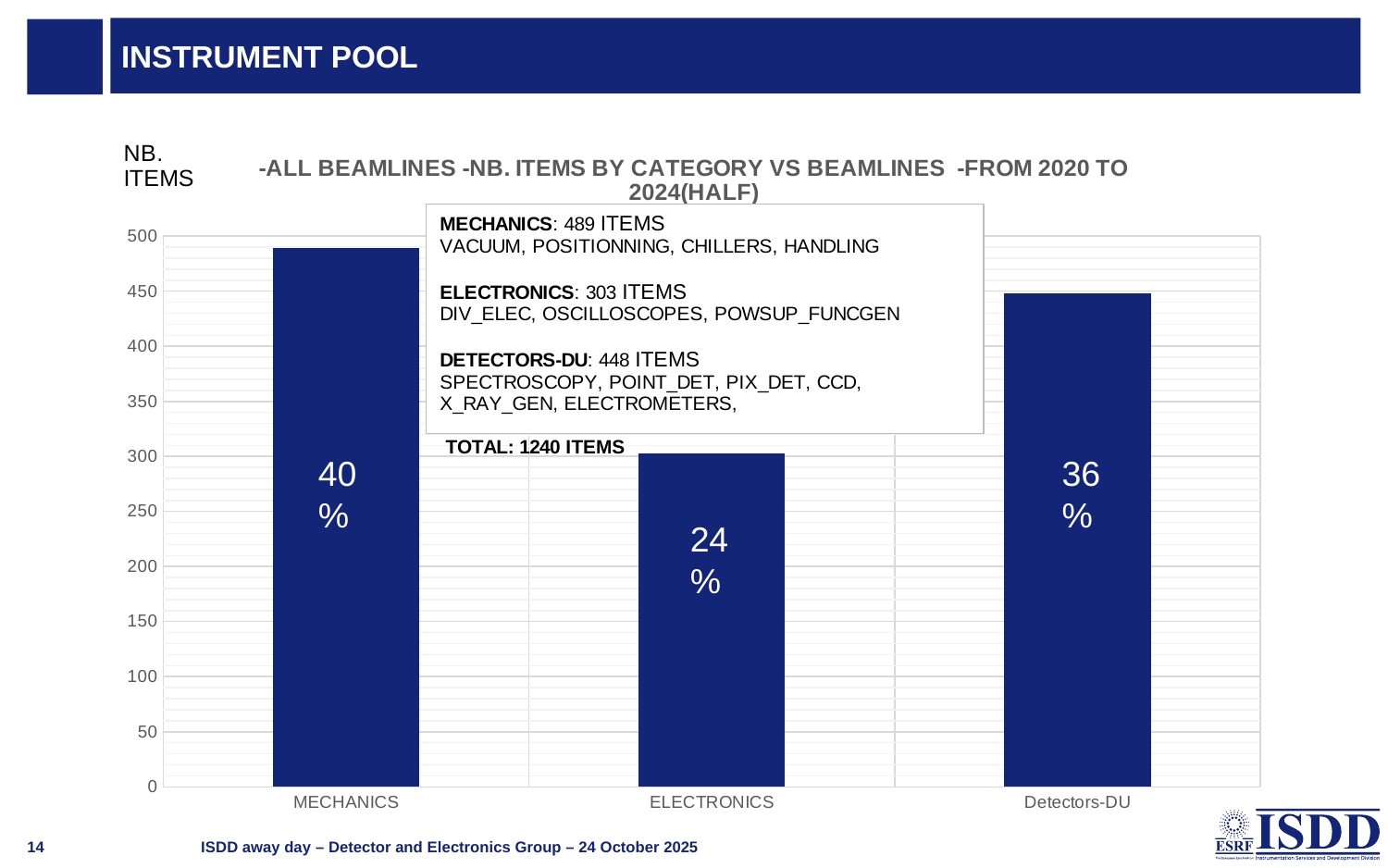
Which category has the highest bar? MECHANICS According to the text box on the chart, how many items does MECHANICS have? 489 ITEMS How many categories are plotted on the x axis of the chart? 3 Is the value for Detectors-DU greater or less than 400? greater Which bar is taller, ELECTRONICS or Detectors-DU? Detectors-DU What is the title of the chart? -ALL BEAMLINES -NB. ITEMS BY CATEGORY VS BEAMLINES -FROM 2020 TO 2024(HALF) Is the value for ELECTRONICS greater or less than 350? less What percentage label is shown on the ELECTRONICS bar? 24% What percentage label is shown on the MECHANICS bar? 40% What percentage label is shown on the Detectors-DU bar? 36% Which category has the lowest bar? ELECTRONICS What type of chart is shown on the slide? bar chart